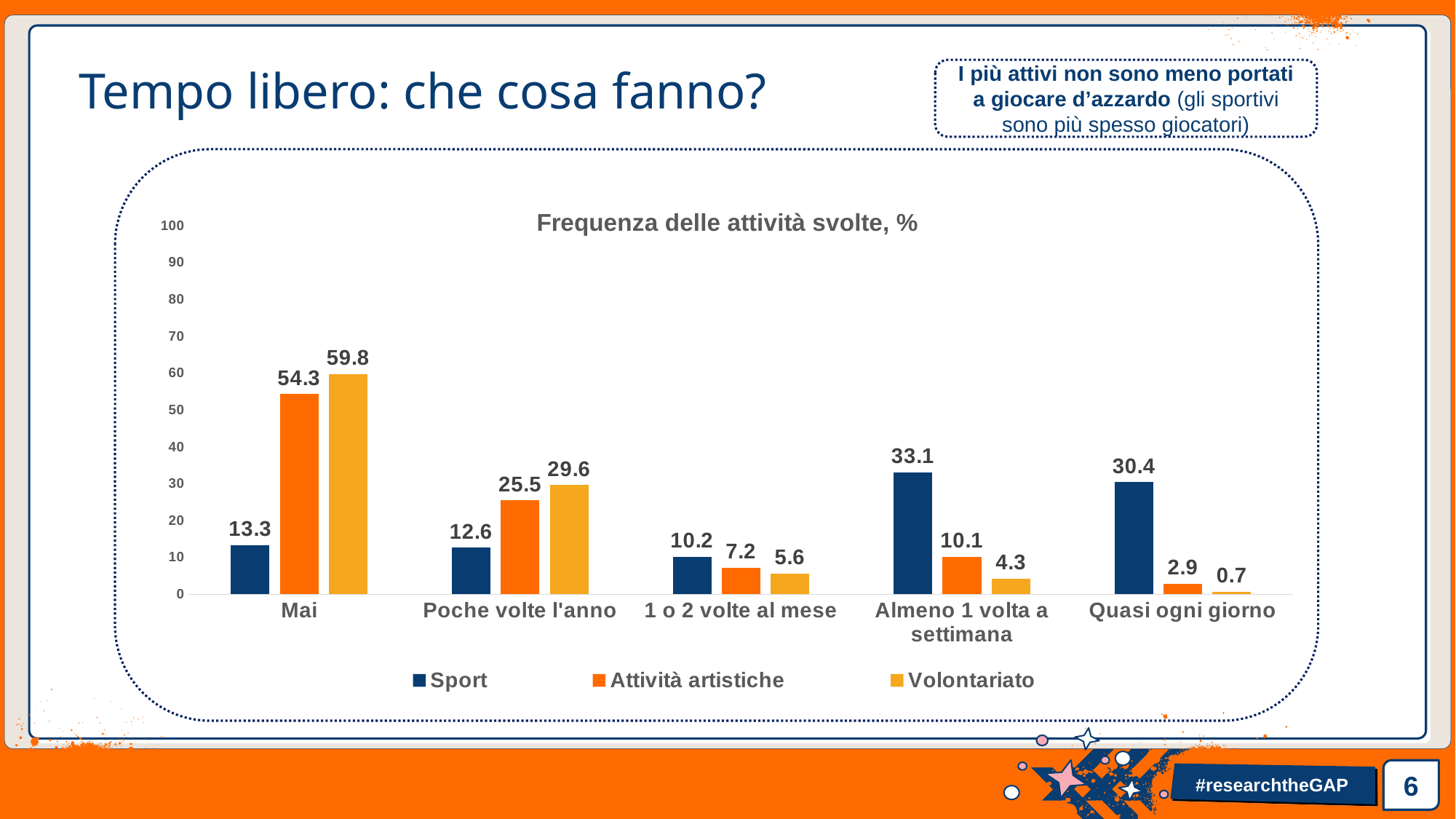
What is the value for Attività artistiche in the 'Quasi ogni giorno' category? 2.9 What is the value for Sport in the 'Mai' category? 13.3 How many categories are shown on the x axis? 5 What kind of chart is shown on the slide? Bar chart Is the value for Attività artistiche in the 'Mai' category greater or less than 50? greater How many series does the legend list? 3 Which is larger in the '1 o 2 volte al mese' category: Sport or Attività artistiche? Sport Which category has the lowest value for Volontariato? Quasi ogni giorno What is the value for Volontariato in the 'Poche volte l'anno' category? 29.6 What is the difference between the Volontariato and Sport values in the 'Mai' category? 46.5 Which category has the highest value for Sport? Almeno 1 volta a settimana What is the title of the chart? Frequenza delle attività svolte, %